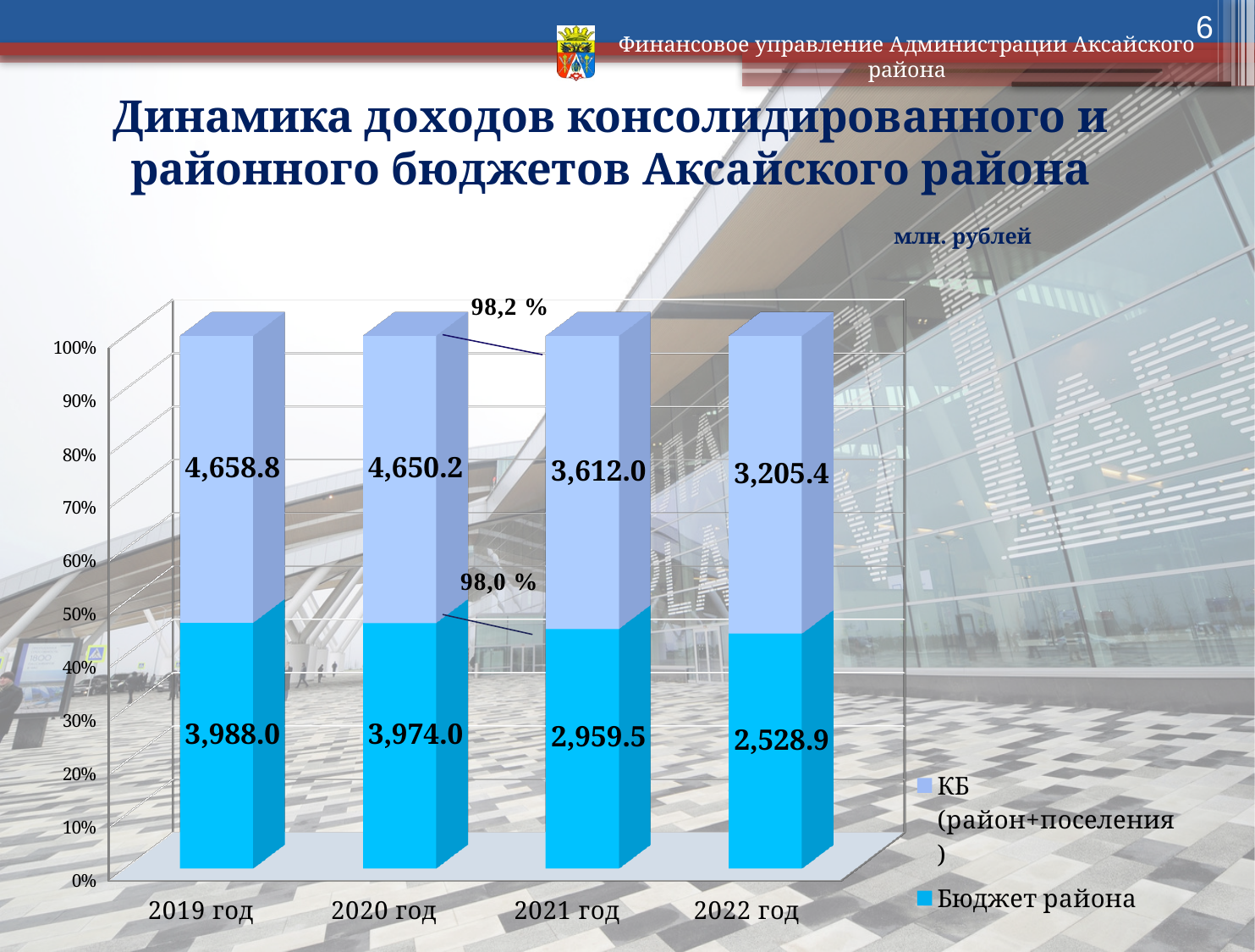
What is the value of КБ (район+поселения) for 2019 год? 4,658.8 What is the difference between the КБ (район+поселения) values for 2019 год and 2022 год? 1,453.4 What is the difference between the Бюджет района values for 2019 год and 2020 год? 14.0 Which year has the larger Бюджет района value, 2020 год or 2021 год? 2020 год What is the value of Бюджет района for 2022 год? 2,528.9 Do the КБ (район+поселения) values rise or fall from 2019 год to 2022 год? Fall In which year is the Бюджет района value the lowest? 2022 год How many series does the legend list? 2 How many years are shown on the x axis of the chart? 4 What is the value of Бюджет района for 2021 год? 2,959.5 In which year is the КБ (район+поселения) value the highest? 2019 год What kind of chart is shown on the slide? Stacked bar chart